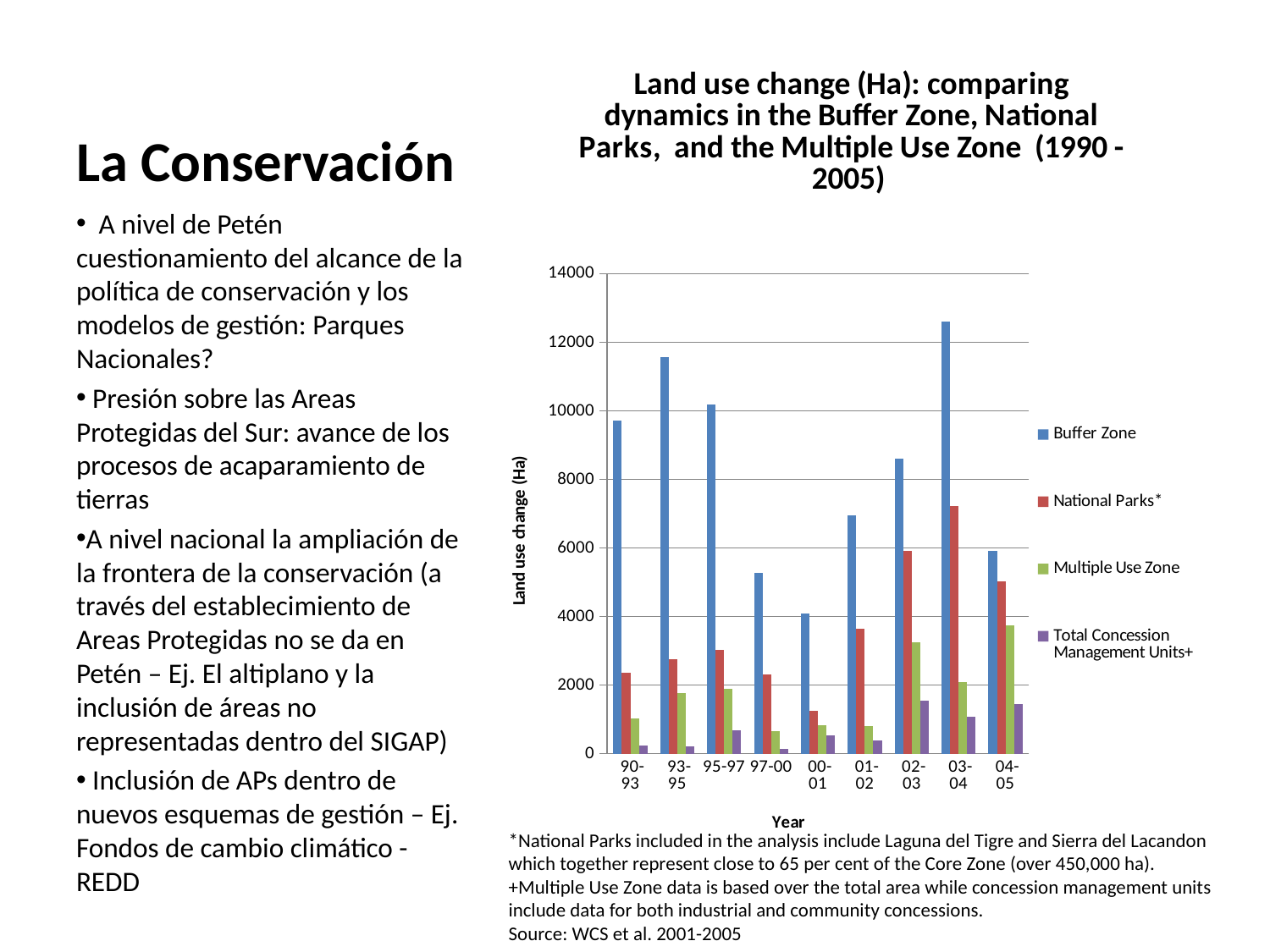
In which year period is the National Parks* value highest? 03-04 In which year period is the Buffer Zone value highest? 03-04 In which year period is the Buffer Zone value lowest? 00-01 Is the Multiple Use Zone value for 04-05 greater or less than 4000? less What is the label of the vertical axis of the chart? Land use change (Ha) Which is larger, the Buffer Zone value for 90-93 or for 93-95? 93-95 How many year categories are shown on the x axis of the chart? 9 Is the Buffer Zone value for 03-04 greater or less than 12000? greater Do the Buffer Zone values rise or fall from 93-95 to 00-01? Fall Is the National Parks* value for 03-04 greater or less than 6000? greater How many series does the chart legend list? 4 What kind of chart is shown on the slide? Bar chart